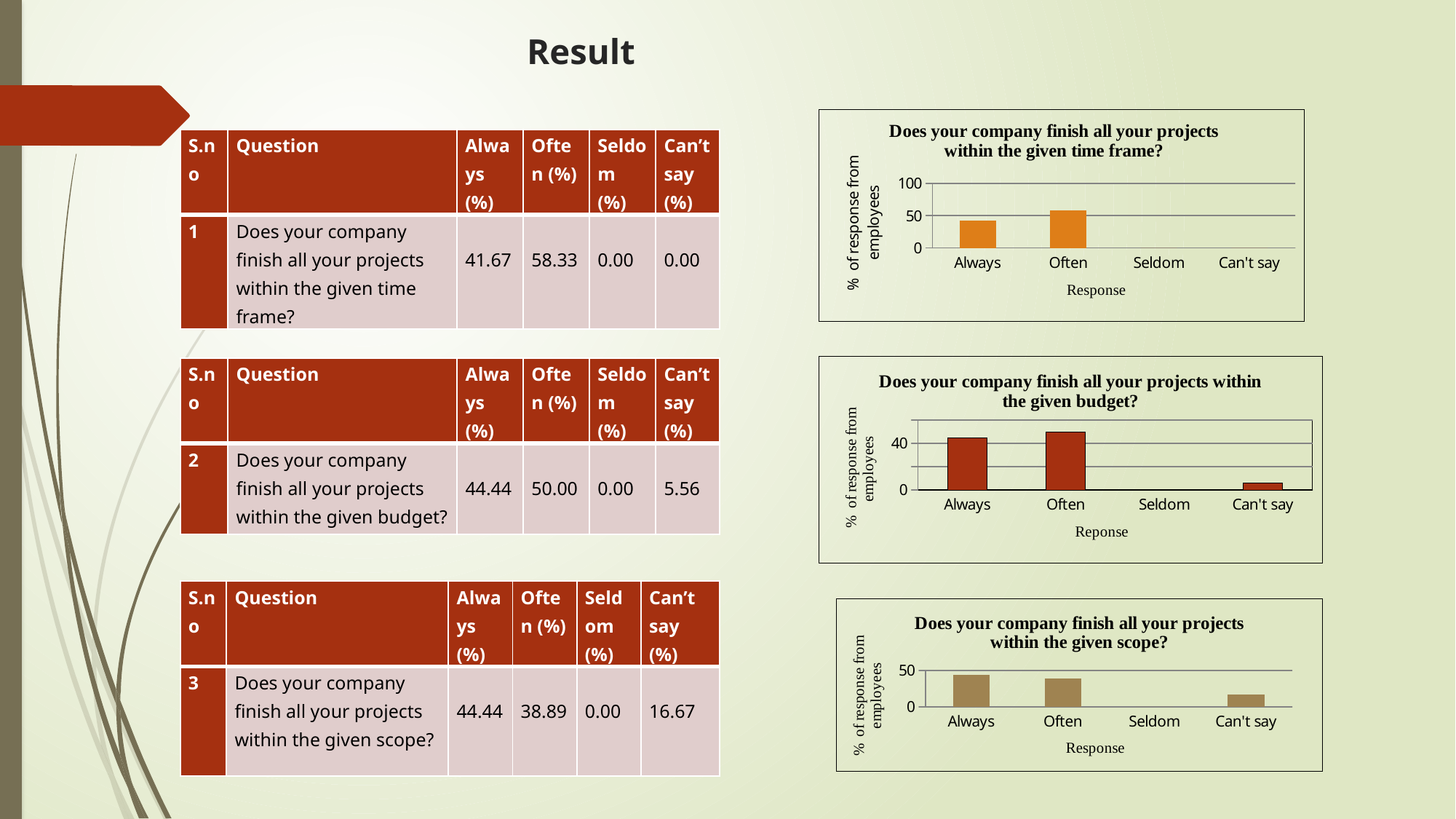
In the 'within the given time frame' chart, is the value for Often greater or less than 50? greater What is the x-axis title of the 'within the given scope' chart? Response In the 'within the given budget' chart, which response has the highest bar? Often How many response categories are shown on the x axis of the 'within the given time frame' chart? 4 In the 'within the given budget' chart, is the value for Can't say greater or less than 40? less In the 'within the given budget' chart, which is larger, the bar for Always or the bar for Can't say? Always In the 'within the given time frame' chart, which response has the highest bar? Often According to the table for question 3, what percentage of employees answered Can't say for the 'within the given scope' chart? 16.67 What kind of chart is the 'Does your company finish all your projects within the given time frame?' chart? bar chart In the 'within the given time frame' chart, is the value for Always greater or less than 50? less In the 'within the given scope' chart, which response has the highest bar? Always